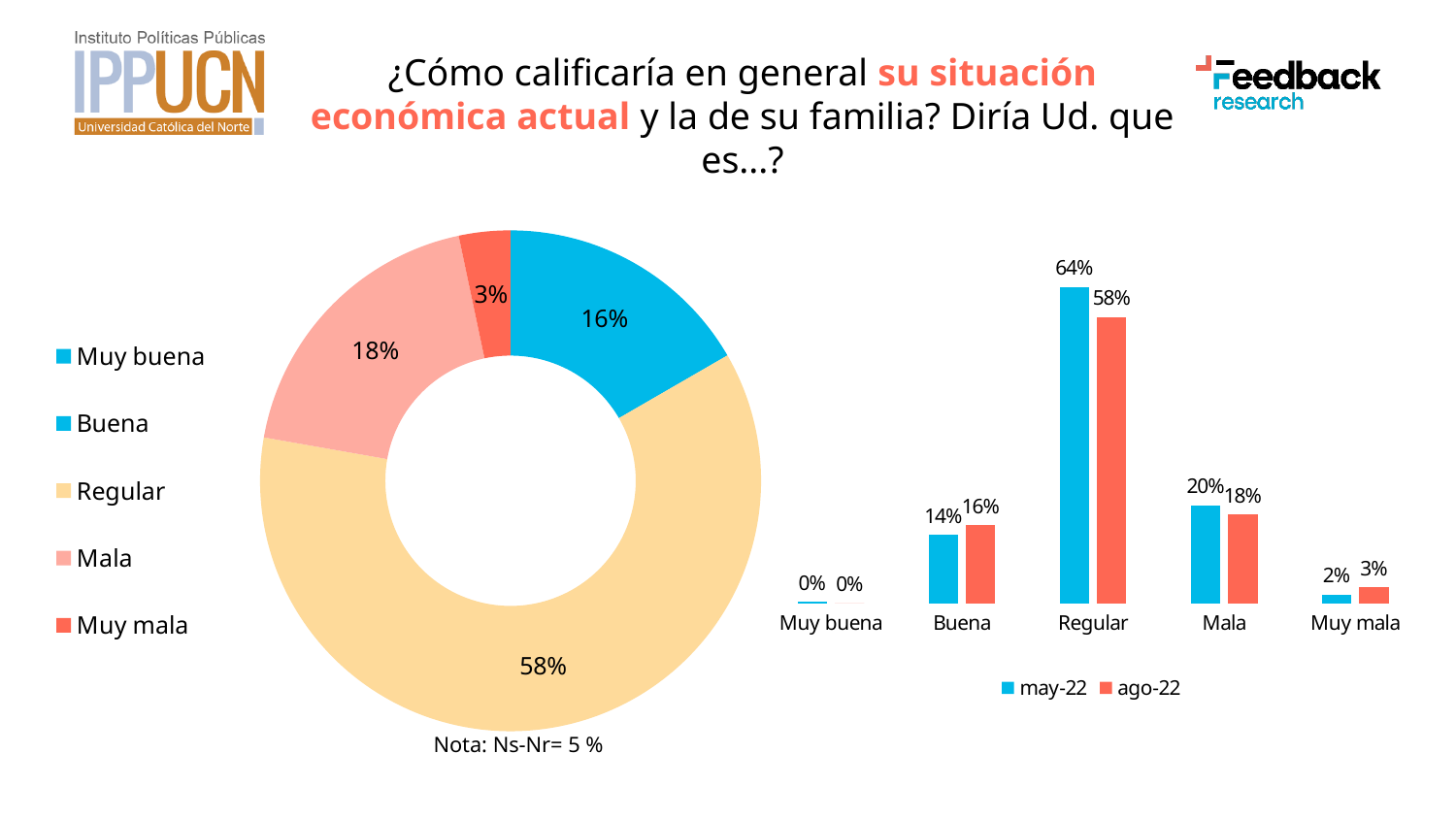
In the bar chart on the right, what is the difference between the may-22 and ago-22 values for Regular? 6% In the donut chart on the left, what share is labelled for Mala? 18% In the bar chart on the right, which is larger for Mala: may-22 or ago-22? may-22 What kind of chart is shown on the right side of the slide? Bar chart In the bar chart on the right, what is the value for Regular in may-22? 64% What does the note below the donut chart say? Nota: Ns-Nr= 5 % In the bar chart on the right, which category has the lowest values in both series? Muy buena In the donut chart on the left, how many categories does the legend list? 5 In the bar chart on the right, how many series does the legend list? 2 In the donut chart on the left, which category has the largest slice? Regular In the donut chart on the left, what share is labelled for Regular? 58% In the bar chart on the right, what is the value for Buena in ago-22? 16%